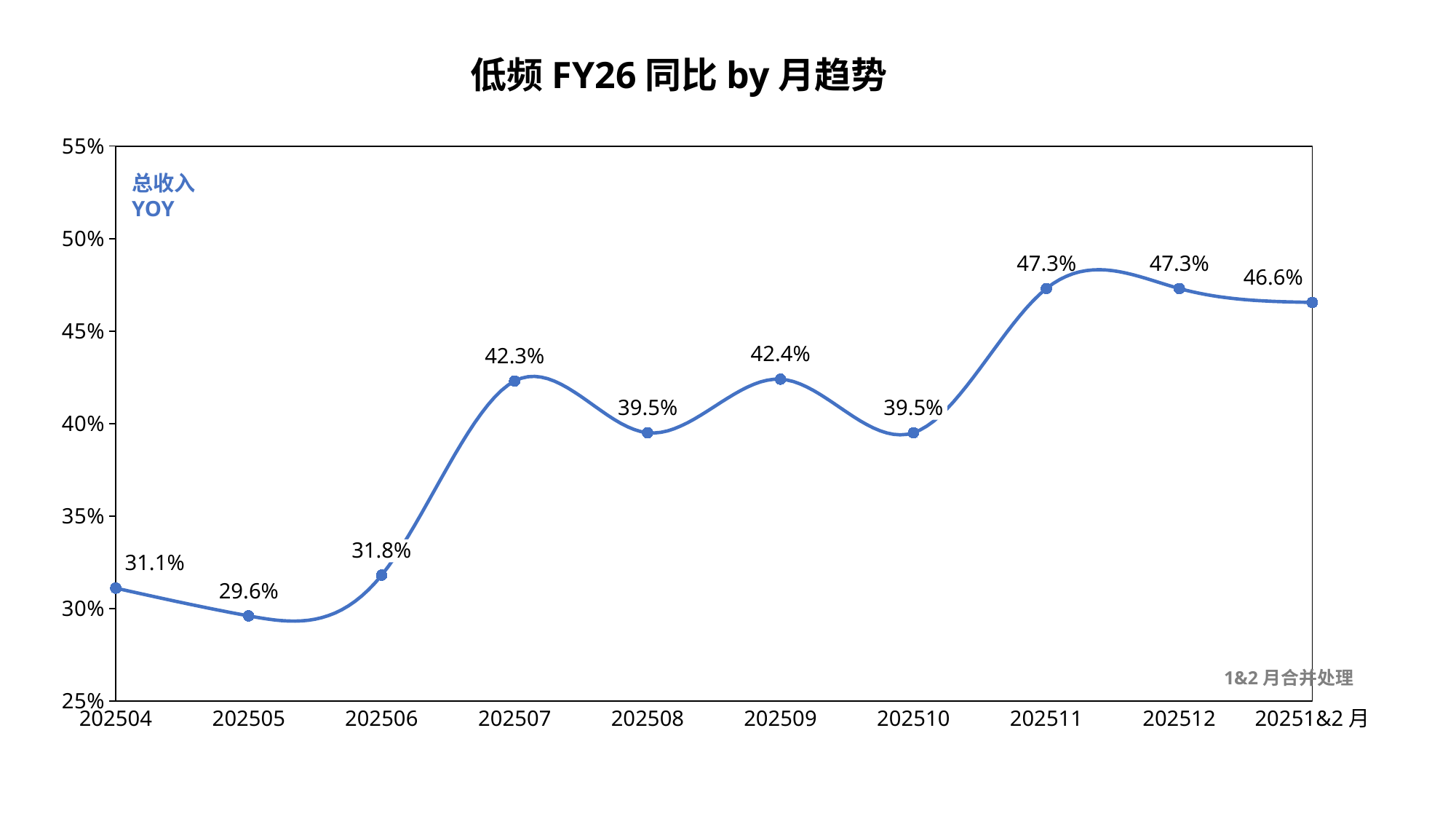
Does the value rise or fall from 202510 to 202511? rise What is the difference between the values for 202507 and 202506? 10.5% Which is larger, the value for 202509 or the value for 202508? 202509 Which month has the lowest value? 202505 What is the value for 20251&2月? 46.6% What kind of chart is shown on the slide? line chart What is the highest value shown on the chart? 47.3% Is the value for 202511 greater or less than 45%? greater What is the title of the chart? 低频 FY26 同比 by 月趋势 How many data points are plotted on the chart? 10 What is the value for 202507? 42.3% What is the value for 202505? 29.6%